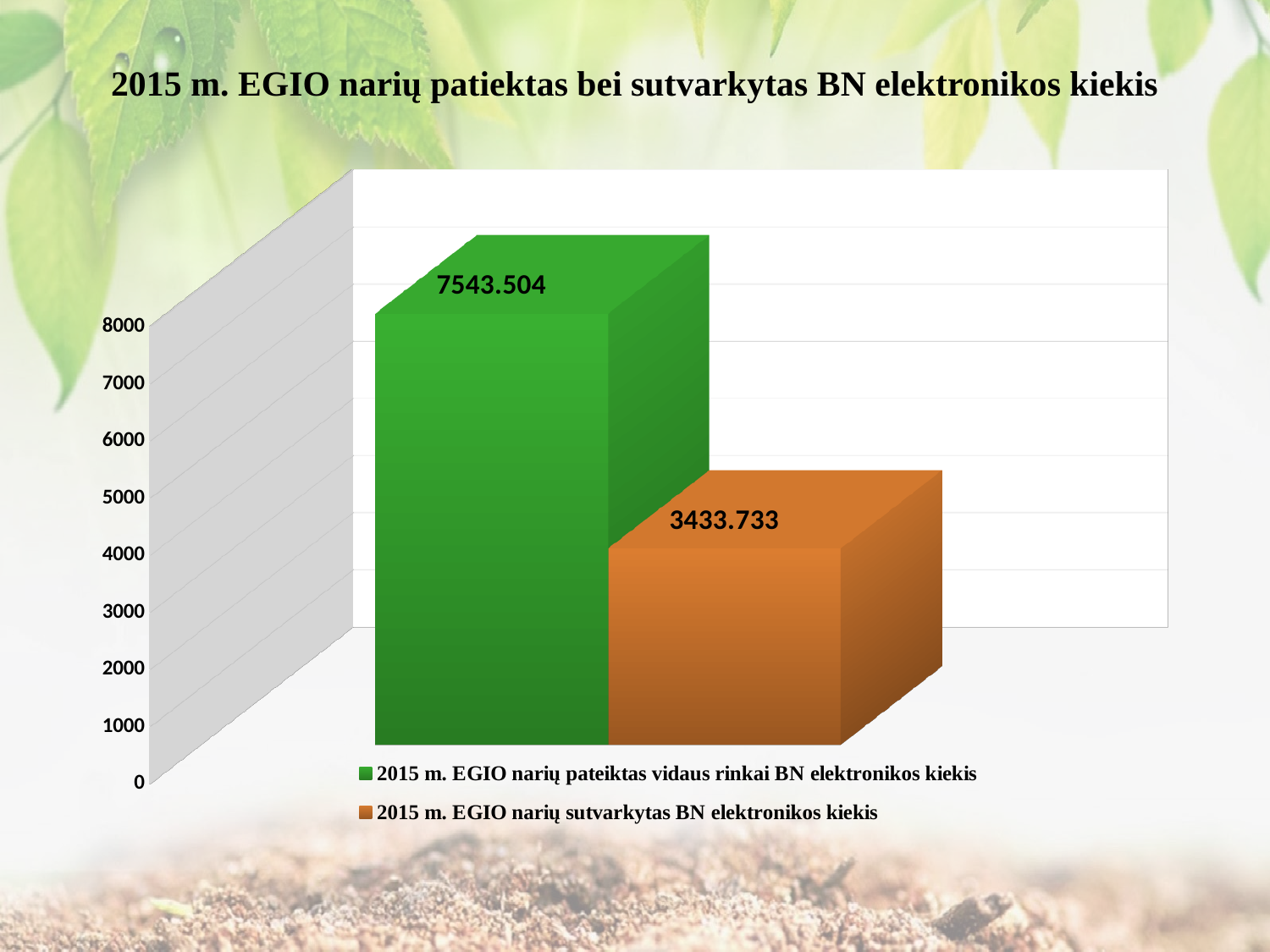
What is the value for '2015 m. EGIO narių pateiktas vidaus rinkai BN elektronikos kiekis'? 7543.504 What kind of chart is shown on the slide? bar chart What is the difference between the value for 'pateiktas vidaus rinkai' and the value for 'sutvarkytas'? 4109.771 Is the value for '2015 m. EGIO narių pateiktas vidaus rinkai BN elektronikos kiekis' greater or less than 7000? greater What is the title of the chart? 2015 m. EGIO narių patiektas bei sutvarkytas BN elektronikos kiekis Is the value for '2015 m. EGIO narių sutvarkytas BN elektronikos kiekis' greater or less than 4000? less What is the value for '2015 m. EGIO narių sutvarkytas BN elektronikos kiekis'? 3433.733 How many series does the legend list? 2 What colour is the bar for '2015 m. EGIO narių sutvarkytas BN elektronikos kiekis'? orange Which series has the lower value? 2015 m. EGIO narių sutvarkytas BN elektronikos kiekis Which is larger: the value for 'pateiktas vidaus rinkai' or the value for 'sutvarkytas'? pateiktas vidaus rinkai Which series has the higher value? 2015 m. EGIO narių pateiktas vidaus rinkai BN elektronikos kiekis